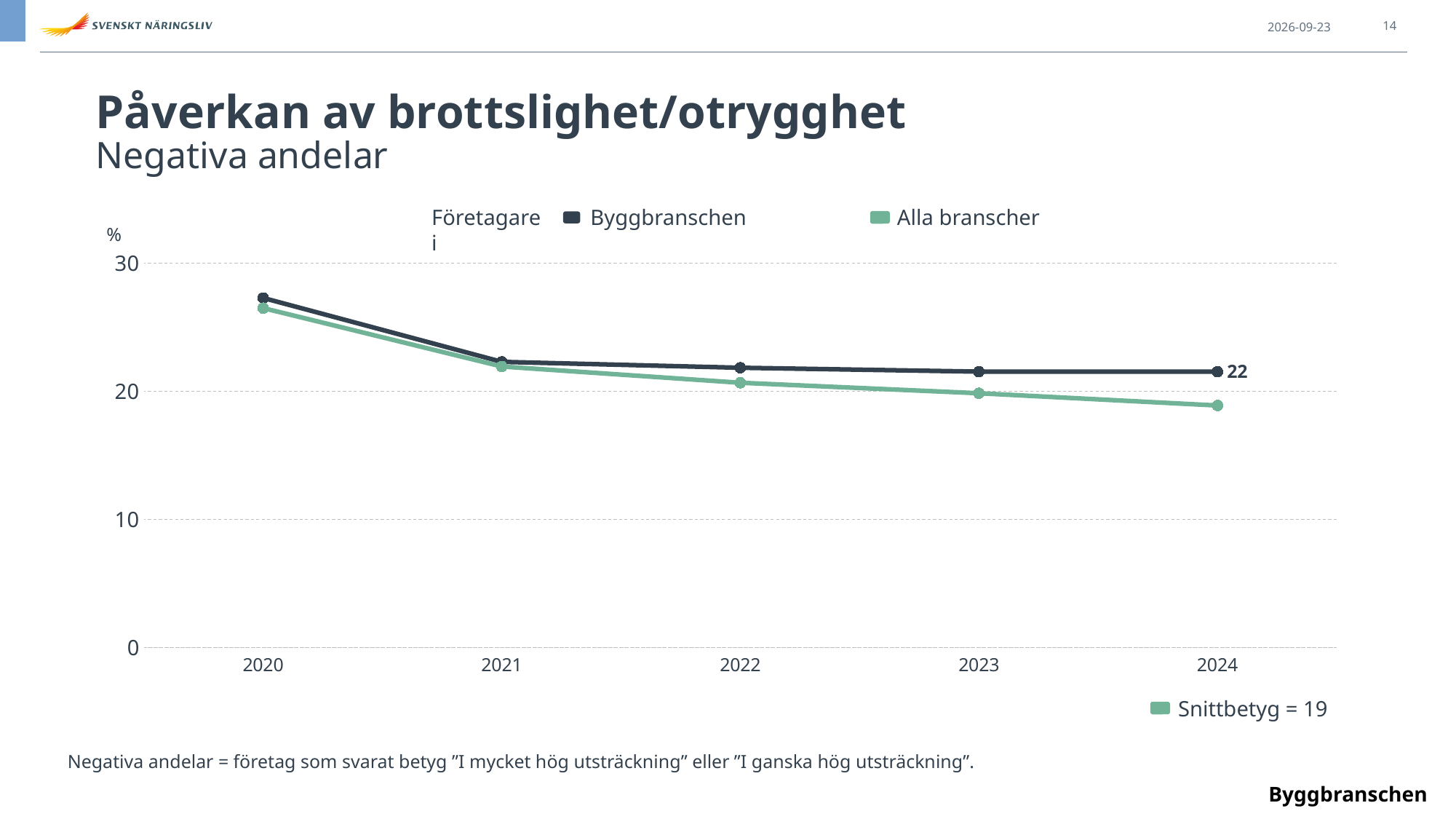
Which series is drawn in green? Alla branscher How many years are plotted along the x axis? 5 What type of chart is shown on the slide? line chart In which year is the value for Alla branscher highest? 2020 In 2024, which series has the larger value, Byggbranschen or Alla branscher? Byggbranschen What is the value for Byggbranschen in 2024? 22 How many series does the chart legend list? 2 In which year is the value for Alla branscher lowest? 2024 Is the value for Alla branscher in 2020 greater or less than 30? less What value is given for Snittbetyg below the chart? 19 Is the value for Byggbranschen in 2020 greater or less than 20? greater Do the values for Byggbranschen rise or fall from 2020 to 2024? fall